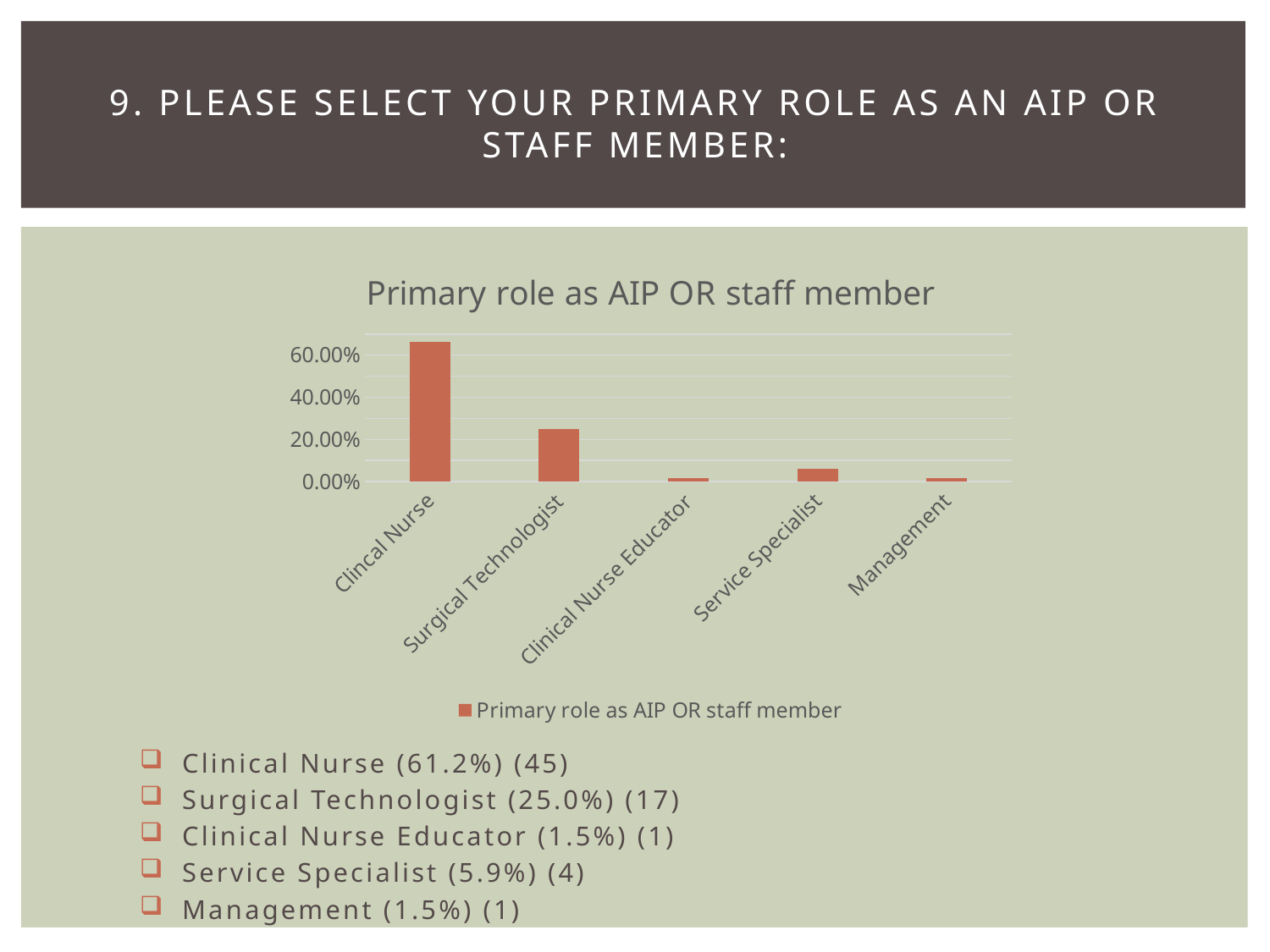
How many series does the chart legend list? 1 What is the title of the chart? Primary role as AIP OR staff member What kind of chart is shown on the slide? bar chart According to the slide, what percentage of respondents selected Surgical Technologist as their primary role? 25.0% Is the value for Service Specialist greater or less than 20.00%? less What is the difference between the percentage for Clinical Nurse and the percentage for Surgical Technologist, as printed on the slide? 36.2% Is the value for Surgical Technologist greater or less than 40.00%? less Which is larger, the value for Surgical Technologist or the value for Service Specialist? Surgical Technologist How many categories are plotted on the x axis of the chart? 5 According to the slide, what percentage of respondents selected Clinical Nurse as their primary role? 61.2% Which category has the highest value in the chart? Clinical Nurse Is the value for Clinical Nurse greater or less than 40.00%? greater